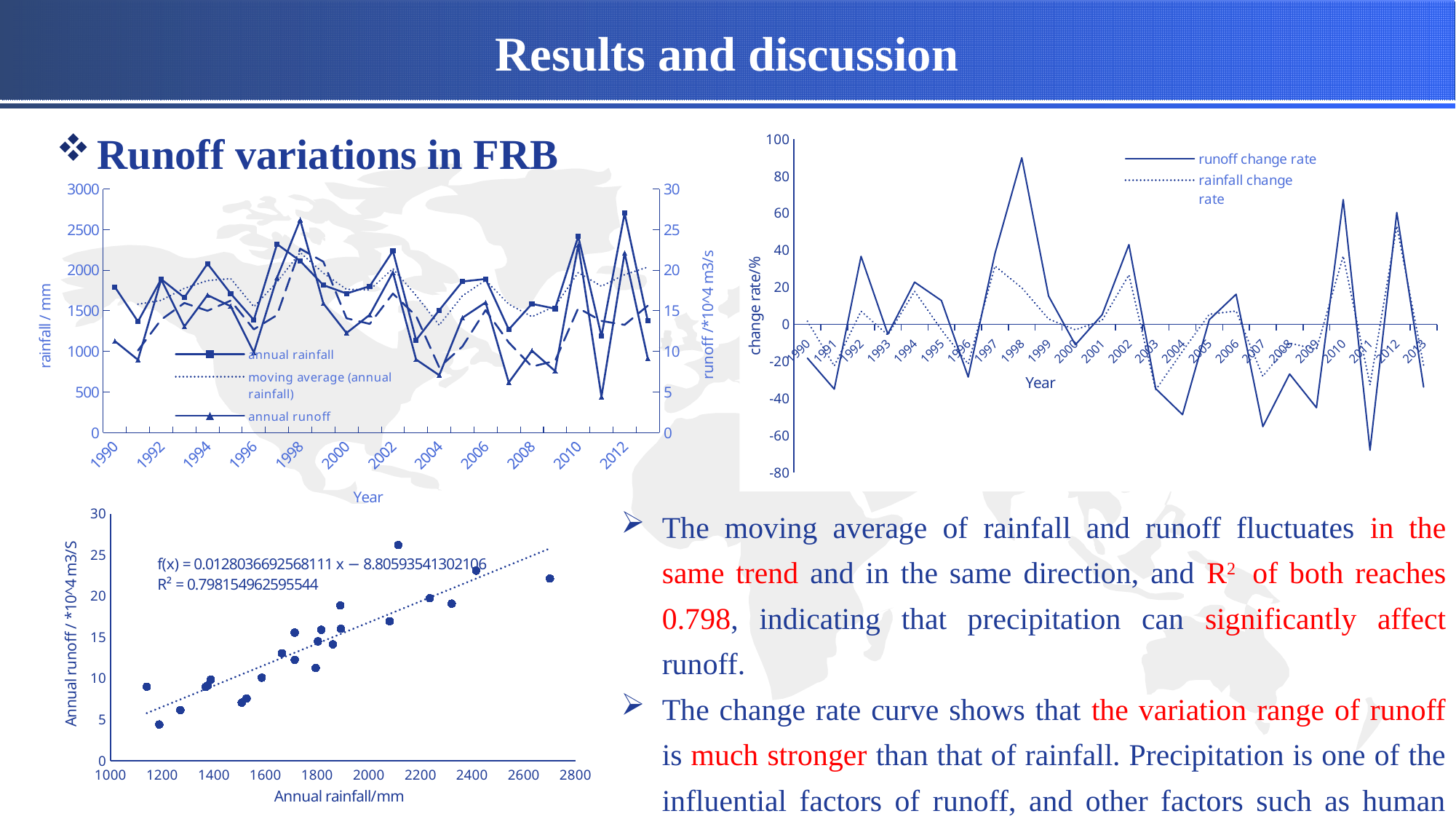
What R² value is printed on the bottom-left scatter chart? 0.798154962595544 What kind of chart is the top-left chart with the 'annual rainfall' legend? line chart In the top-right chart, which is larger in 1998: the runoff change rate or the rainfall change rate? runoff change rate How many series does the legend of the top-right change rate chart list? 2 In the top-right chart, which year has the highest runoff change rate? 1998 In the top-left chart, is the annual rainfall value for 1996 greater or less than 1500? less In the top-right chart, is the runoff change rate for 2011 greater or less than -60? less What kind of chart is the bottom-left chart of annual runoff against annual rainfall? scatter chart How many series does the legend of the top-left chart list? 3 In the top-right chart, is the runoff change rate for 1998 greater or less than 80? greater